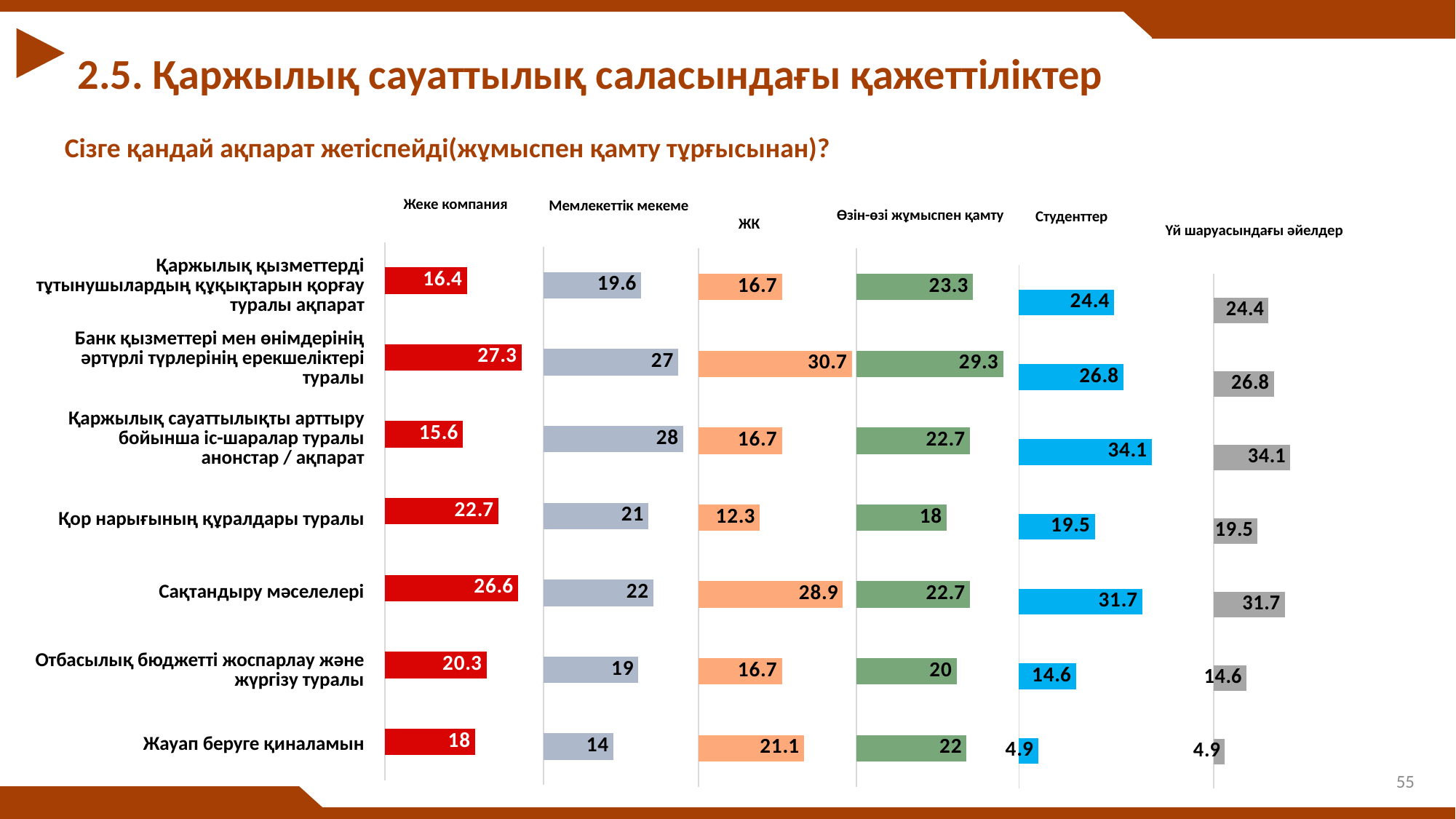
What colour are the bars in the 'Өзін-өзі жұмыспен қамту' chart? Green In the 'ЖК' chart, what is the value for 'Жауап беруге қиналамын'? 21.1 What type of chart is used for the 'Мемлекеттік мекеме' panel? Bar chart In the 'Студенттер' chart, what is the value for 'Отбасылық бюджетті жоспарлау және жүргізу туралы'? 14.6 In the 'Студенттер' chart, which category has the lowest value? Жауап беруге қиналамын In the 'Өзін-өзі жұмыспен қамту' chart, what is the difference between 'Банк қызметтері мен өнімдерінің әртүрлі түрлерінің ерекшеліктері туралы' and 'Қор нарығының құралдары туралы'? 11.3 How many respondent-group charts are shown on the slide? 6 In the 'ЖК' chart, which category has the highest value? Банк қызметтері мен өнімдерінің әртүрлі түрлерінің ерекшеліктері туралы How many categories are shown in the 'Жеке компания' chart? 7 In the 'Жеке компания' chart, what is the value for 'Сақтандыру мәселелері'? 26.6 In the 'Мемлекеттік мекеме' chart, what is the value for 'Қаржылық сауаттылықты арттыру бойынша іс-шаралар туралы анонстар / ақпарат'? 28 In the 'Үй шаруасындағы әйелдер' chart, which is larger: 'Сақтандыру мәселелері' or 'Қор нарығының құралдары туралы'? Сақтандыру мәселелері